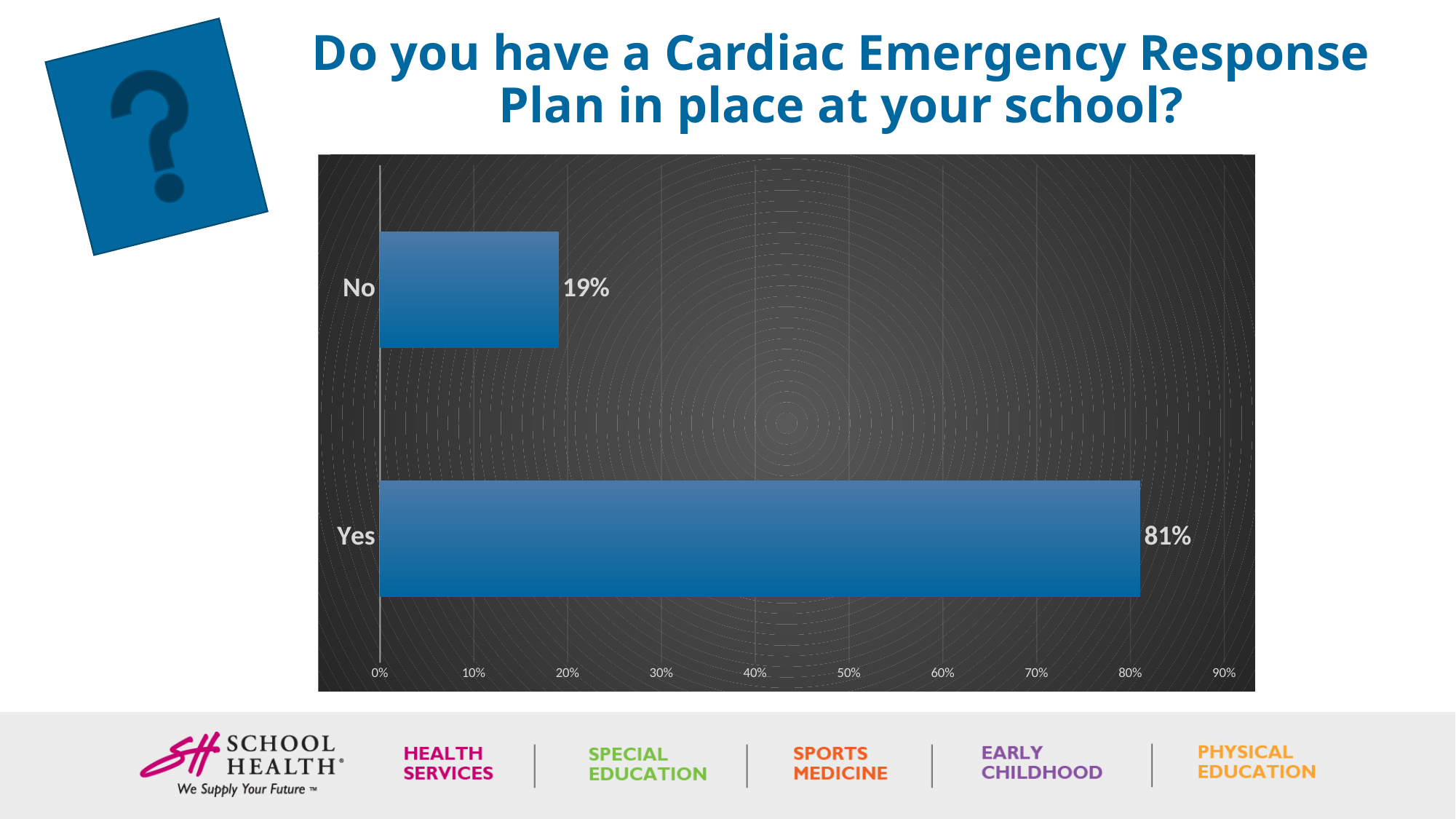
What is the highest value labelled on the horizontal axis? 90% Which response has the higher value? Yes What kind of chart is shown on the slide? bar chart Is the value for No greater or less than 20%? less What percentage of respondents answered Yes? 81% What is the difference between the Yes and No percentages? 62% What percentage of respondents answered No? 19% Is the value for Yes greater or less than 80%? greater Which response has the lower value? No Is the value for Yes larger or smaller than the value for No? larger How many response categories are shown in the chart? 2 What is the total of the Yes and No percentages? 100%